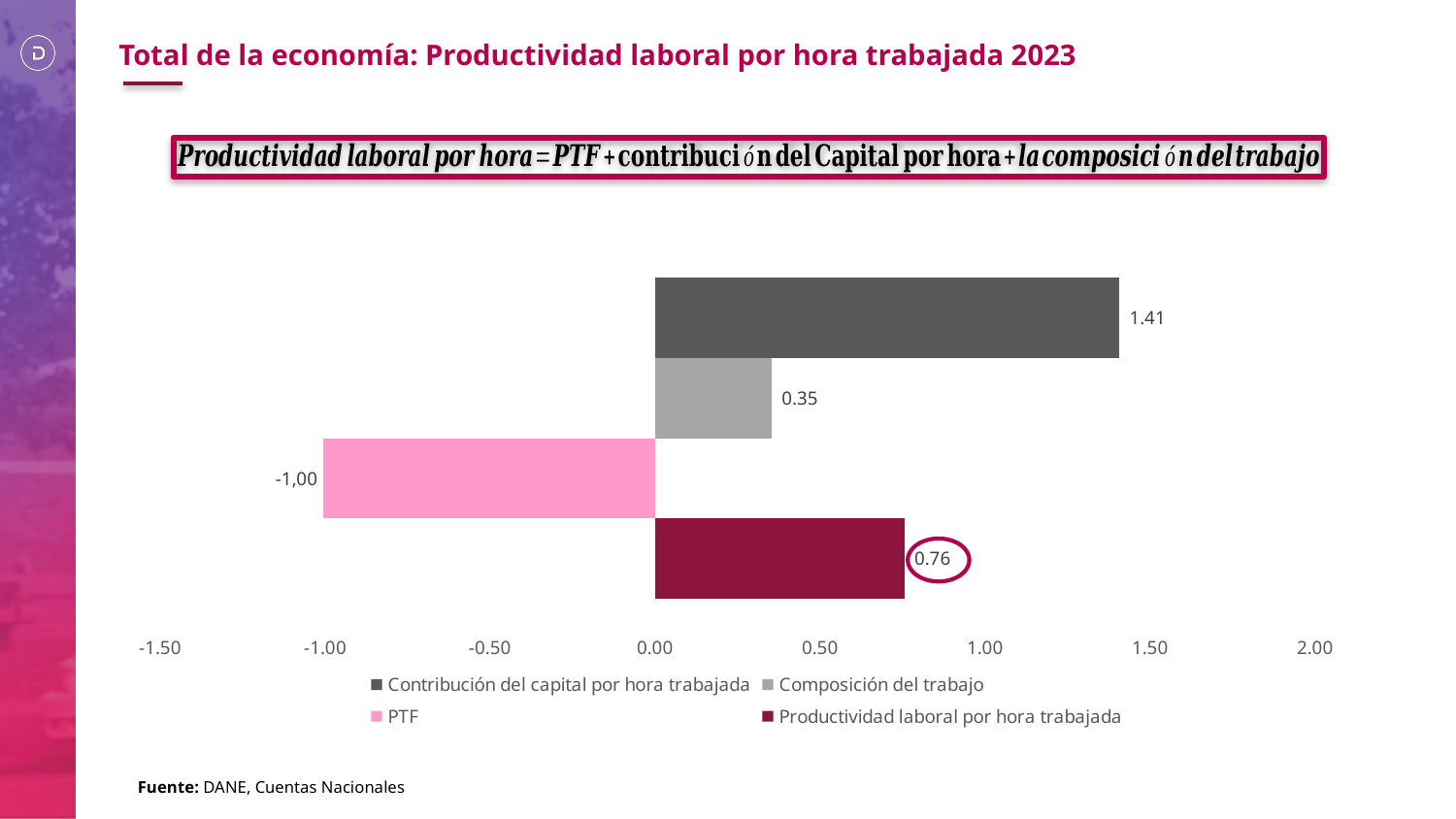
What is the value for Contribución del capital por hora trabajada? 1.41 How many series does the legend list? 4 Which series has the highest value? Contribución del capital por hora trabajada Which is larger, the value for Composición del trabajo or the value for Productividad laboral por hora trabajada? Productividad laboral por hora trabajada What kind of chart is shown on the slide? Bar chart What is the value for Composición del trabajo? 0.35 Which series has the lowest value? PTF Is the value for Contribución del capital por hora trabajada greater or less than 1.00? greater What is the value for Productividad laboral por hora trabajada? 0.76 What is the value for PTF? -1,00 What is the difference between the value for Contribución del capital por hora trabajada and the value for Composición del trabajo? 1.06 What is the title of the slide? Total de la economía: Productividad laboral por hora trabajada 2023